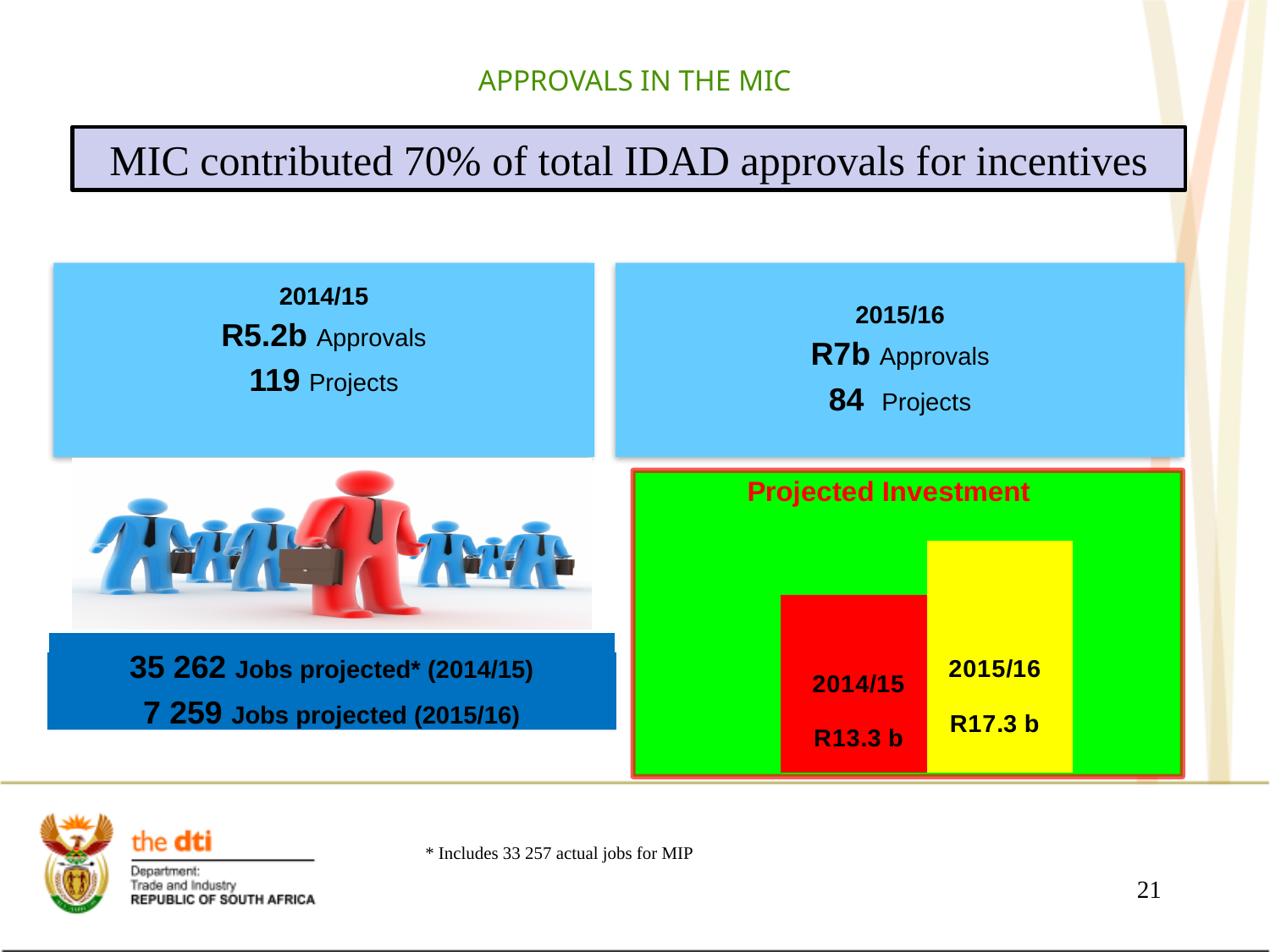
Which year has the lower projected investment in the Projected Investment chart? 2014/15 Which year has the higher projected investment in the Projected Investment chart? 2015/16 In the Projected Investment chart, is the projected investment for 2014/15 larger or smaller than for 2015/16? smaller What is the projected investment for 2014/15 in the Projected Investment chart? R13.3 b What kind of chart is the Projected Investment chart? bar chart What is the difference between the projected investment for 2015/16 and 2014/15 in the Projected Investment chart? R4 b How many bars are shown in the Projected Investment chart? 2 Does the projected investment rise or fall from 2014/15 to 2015/16 in the Projected Investment chart? rise What is the title of the chart on the slide? Projected Investment What colour is the 2015/16 bar in the Projected Investment chart? yellow What is the projected investment for 2015/16 in the Projected Investment chart? R17.3 b